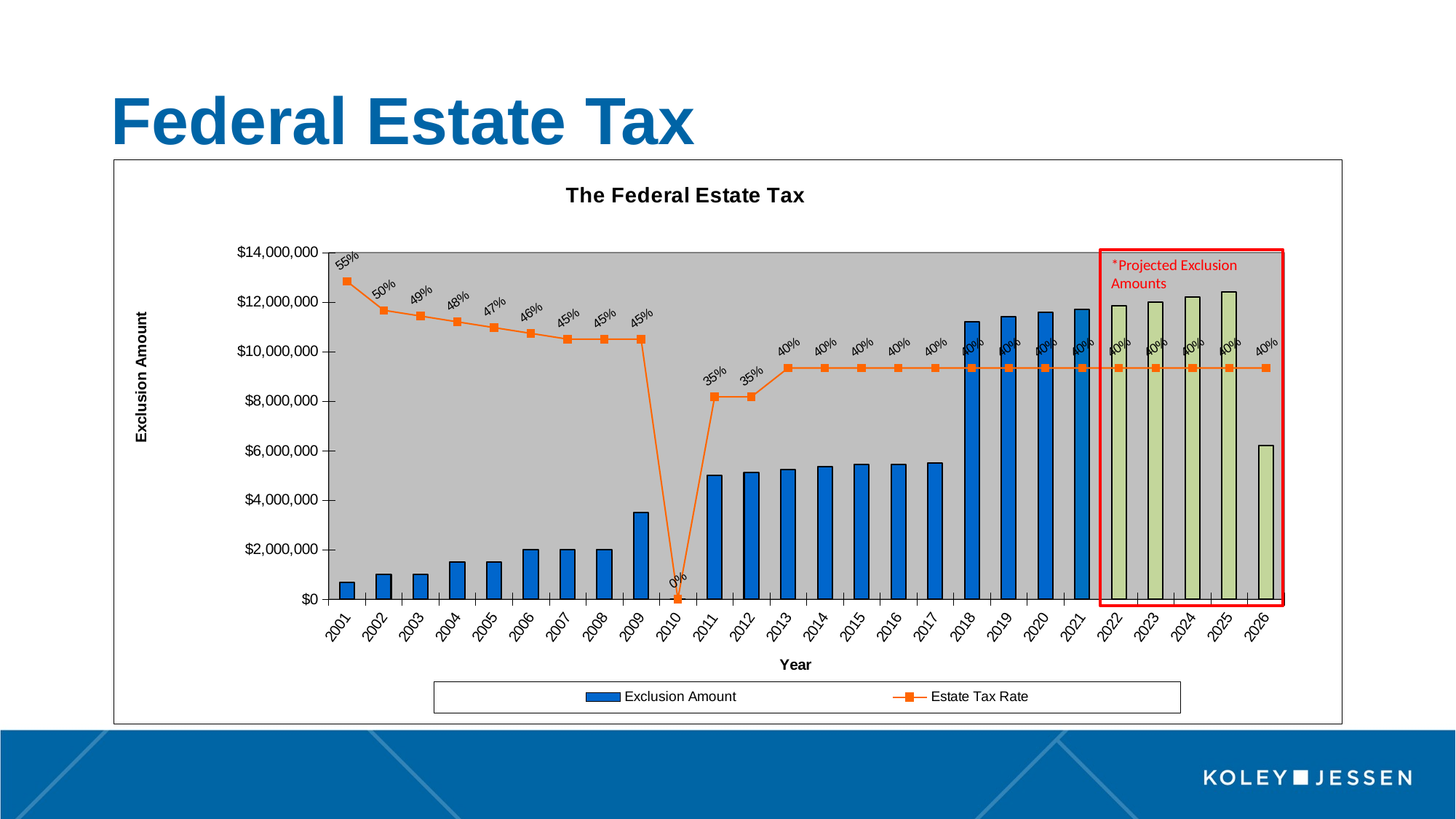
What is the estate tax rate shown for 2010? 0% Which year has the highest estate tax rate? 2001 Which year has the lowest estate tax rate? 2010 Does the estate tax rate rise or fall from 2001 to 2009? fall Which year has the larger exclusion amount, 2021 or 2026? 2021 By how many percentage points did the estate tax rate fall from 2001 to 2002? 5 percentage points How many series does the legend list? 2 What is the estate tax rate shown for 2001? 55% What is the estate tax rate shown for 2011? 35% How many years are shown on the x axis? 26 Is the exclusion amount for 2018 greater or less than $10,000,000? greater Is the exclusion amount for 2026 greater or less than $8,000,000? less